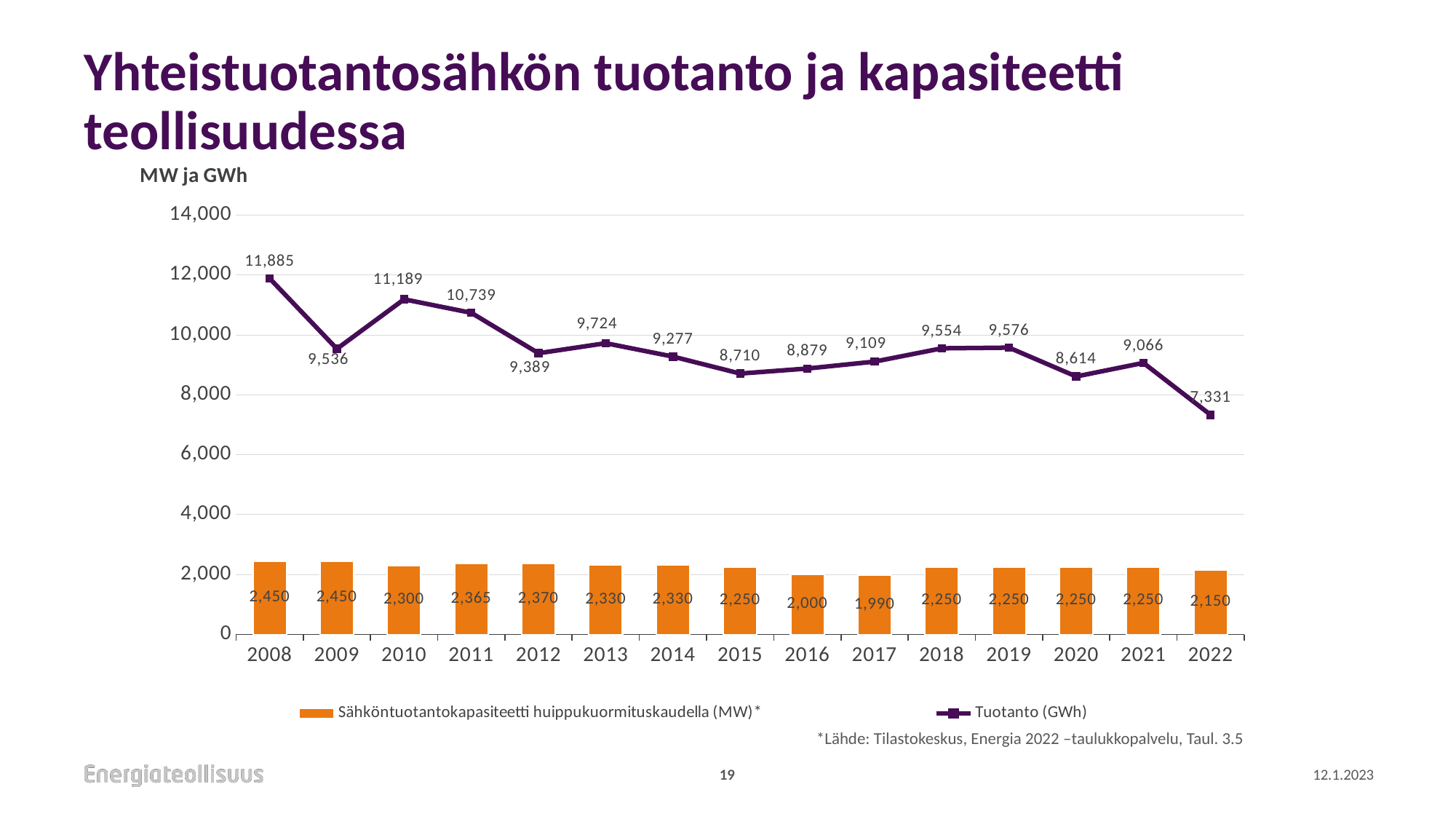
What is the title of the chart? Yhteistuotantosähkön tuotanto ja kapasiteetti teollisuudessa What was the Sähköntuotantokapasiteetti huippukuormituskaudella (MW) value in 2017? 1,990 Which year had a higher Tuotanto (GWh) value, 2010 or 2011? 2010 In which year was Sähköntuotantokapasiteetti huippukuormituskaudella (MW) lowest? 2017 How many series does the legend list? 2 How many years are shown on the x axis? 15 What was the Sähköntuotantokapasiteetti huippukuormituskaudella (MW) value in 2012? 2,370 What was the Tuotanto (GWh) value in 2022? 7,331 In which year was Tuotanto (GWh) highest? 2008 In which year was Tuotanto (GWh) lowest? 2022 What is the difference between the Tuotanto (GWh) values in 2008 and 2022? 4,554 What was the Tuotanto (GWh) value in 2008? 11,885